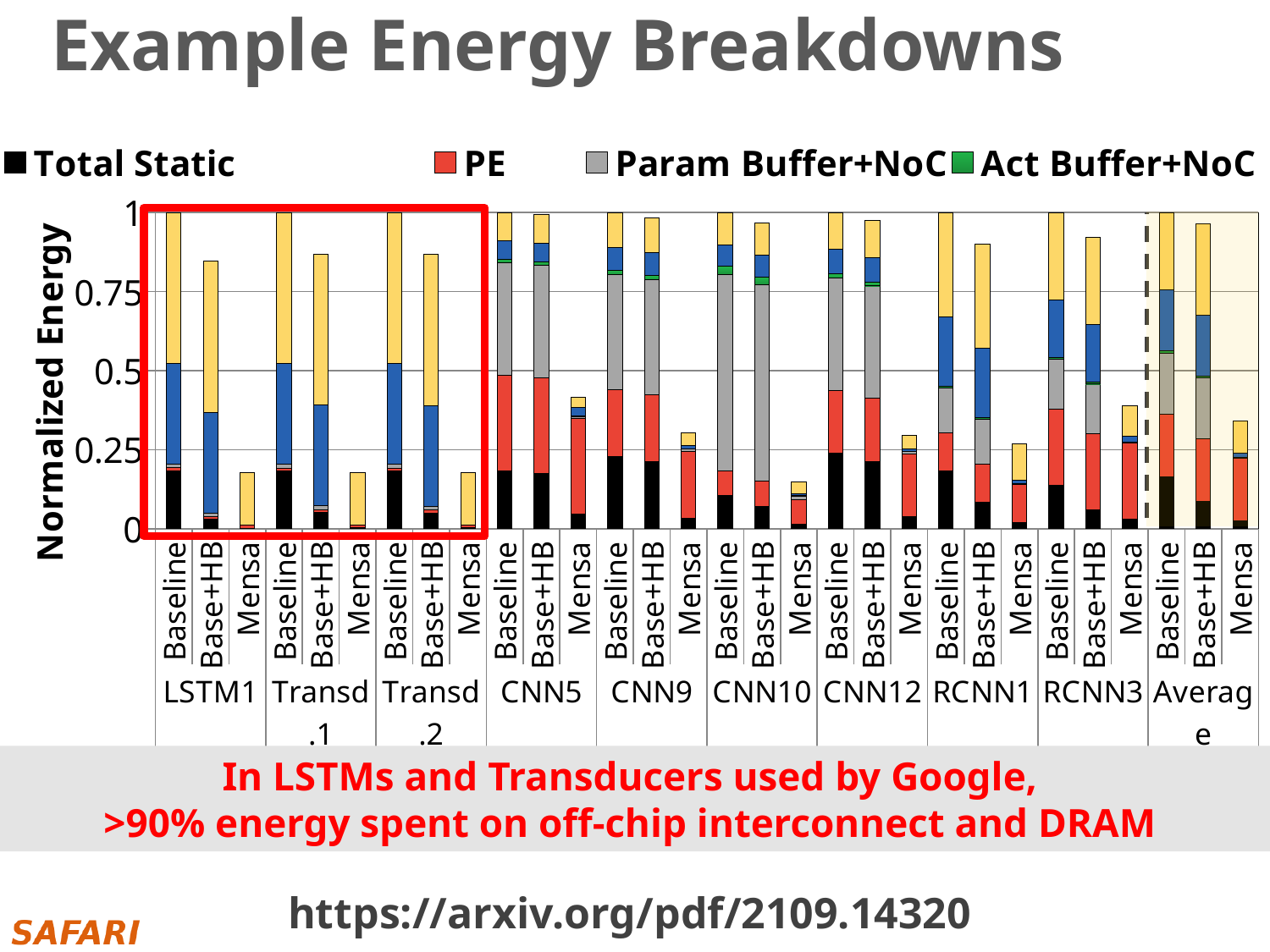
Is the total normalized energy for Mensa in LSTM1 greater or less than 0.25? less Is the total normalized energy for Mensa in the Average group greater or less than 0.25? greater How many workload groups (including Average) are shown along the x axis? 10 What is the total normalized energy of the Baseline bar for LSTM1? 1 How many series does the chart legend list? 4 What is the label of the y axis? Normalized Energy What kind of chart is shown on the slide? Stacked bar chart Is the total normalized energy for Mensa in CNN5 greater or less than 0.5? less Within the CNN5 group, which configuration has the lowest total normalized energy? Mensa How many bars are shown for each workload group? 3 Which has the larger total normalized energy: Mensa in CNN5 or Mensa in LSTM1? Mensa in CNN5